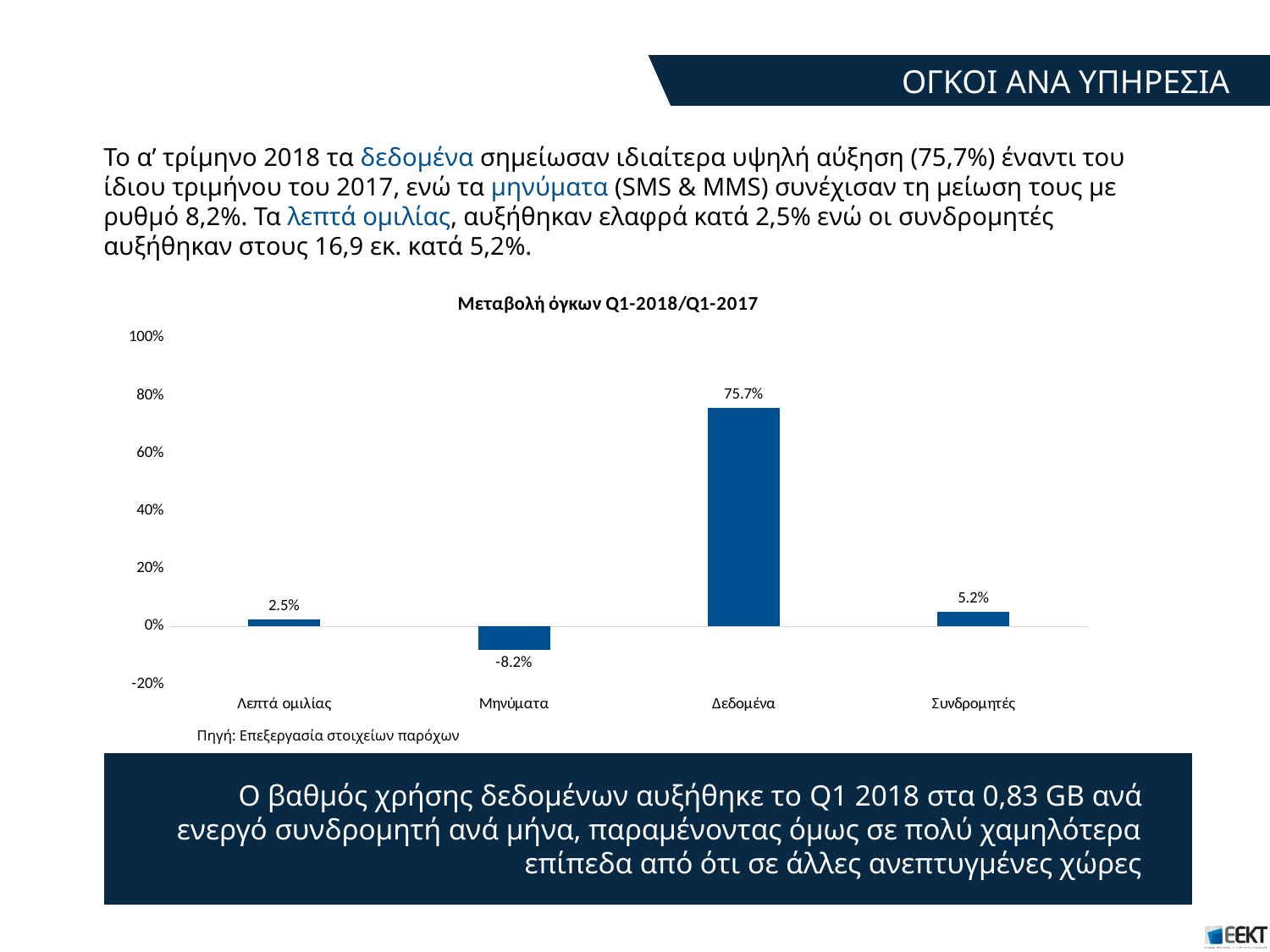
What is the value for Λεπτά ομιλίας in the chart? 2.5% What is the title of the chart? Μεταβολή όγκων Q1-2018/Q1-2017 Which is larger, the value for Συνδρομητές or the value for Λεπτά ομιλίας? Συνδρομητές What is the value for Δεδομένα in the chart? 75.7% What kind of chart is shown on the slide? bar chart What is the value for Συνδρομητές in the chart? 5.2% Which category has the lowest value in the chart? Μηνύματα What is the value for Μηνύματα in the chart? -8.2% Is the value for Δεδομένα greater or less than 60%? greater What is the difference between the values for Δεδομένα and Συνδρομητές? 70.5% How many categories are shown in the chart? 4 Which category has the highest value in the chart? Δεδομένα